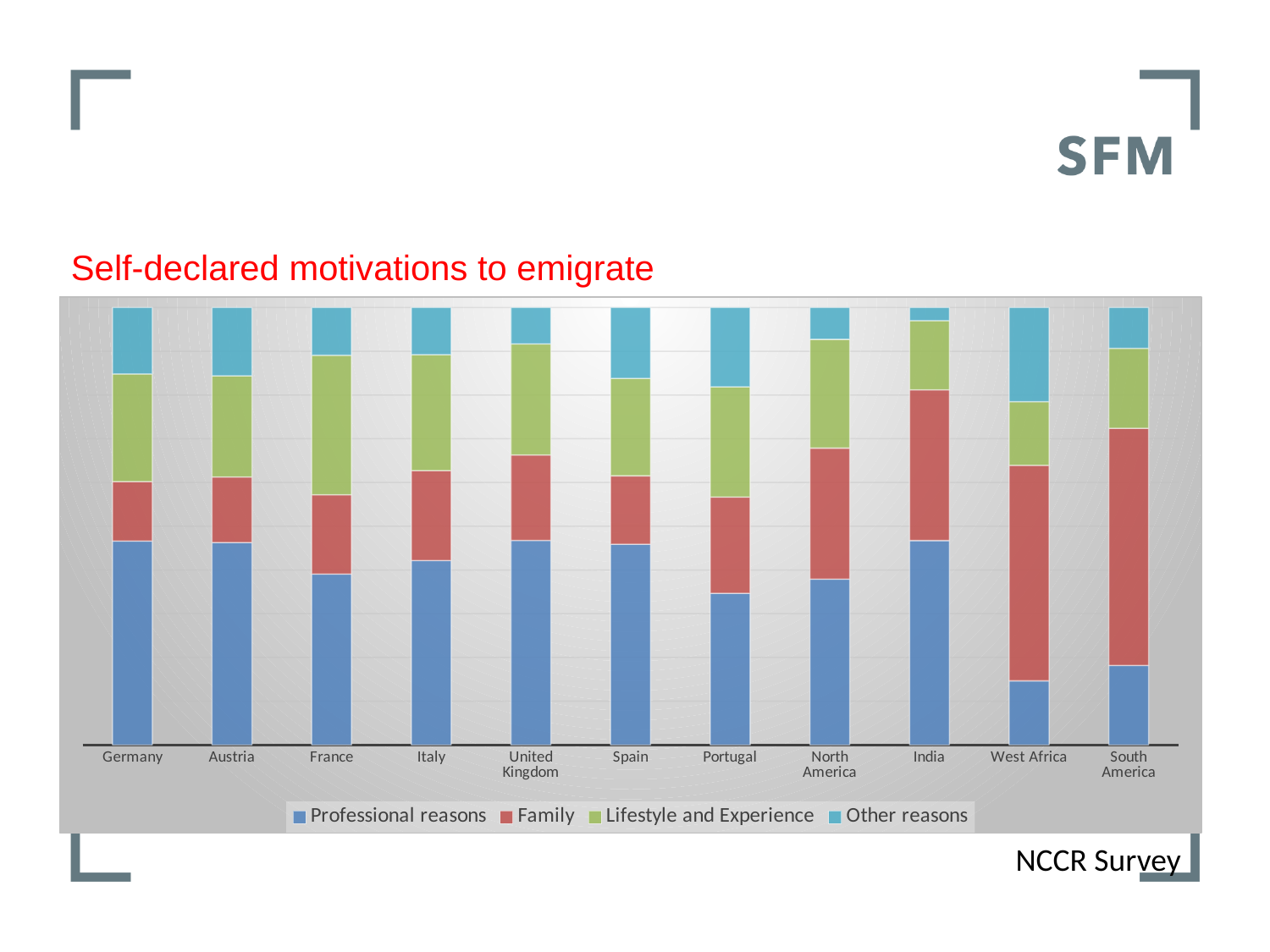
How many countries or regions are shown on the x axis of the chart? 11 Which country or region has the smallest Other reasons segment? India Which series is shown in red in the chart? Family How many series does the chart's legend list? 4 Is the Family segment larger for Portugal or for Austria? Portugal Is the Other reasons segment larger for Germany or for India? Germany Is the Lifestyle and Experience segment larger for France or for South America? France Which country or region has the smallest Professional reasons segment? West Africa What is the title of the chart? Self-declared motivations to emigrate What kind of chart is shown on the slide? Stacked bar chart